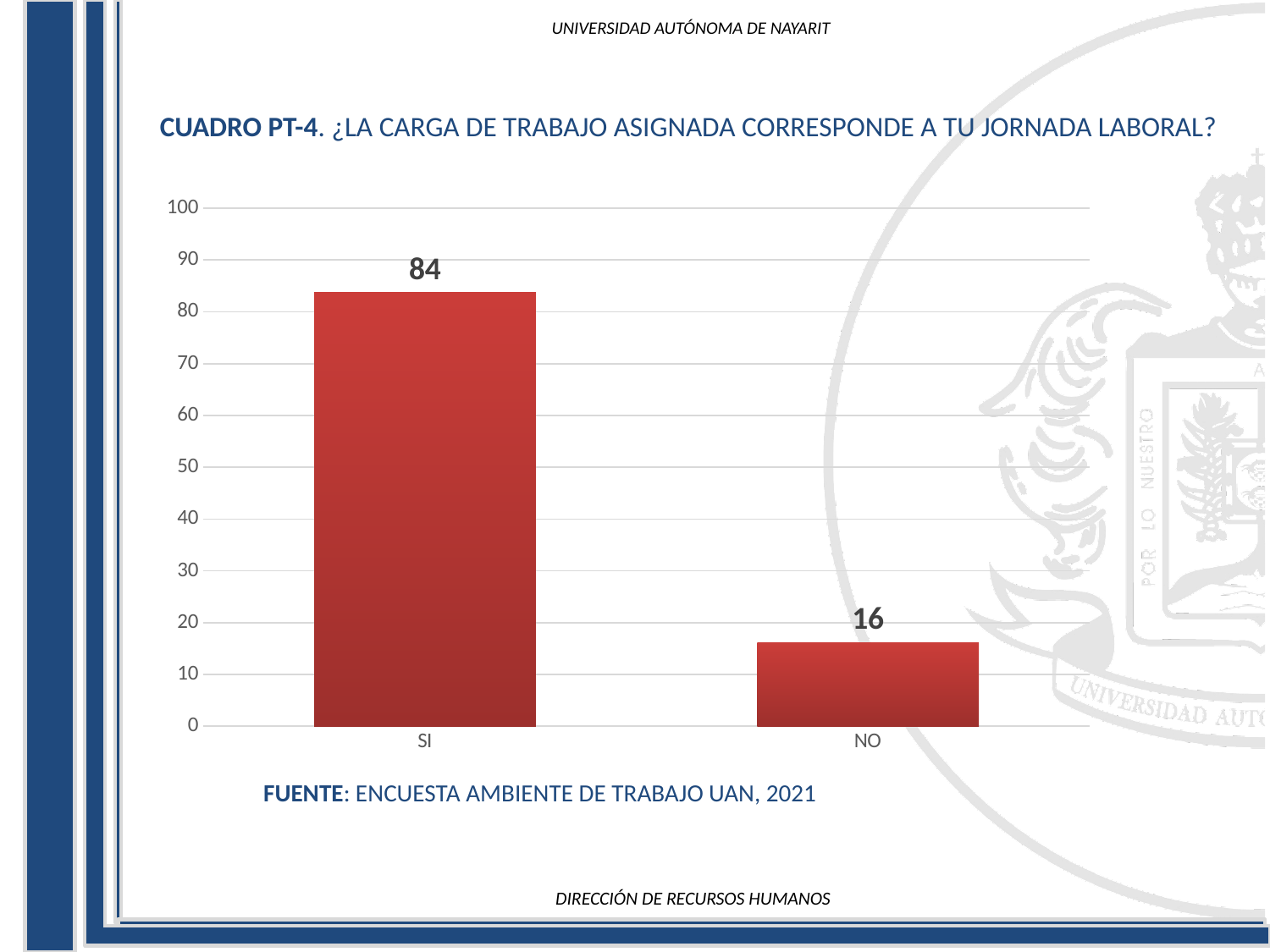
What is the value for SI? 84 What kind of chart is shown on the slide? bar chart Is the value for SI greater or less than 80? greater What is the difference between the values for SI and NO? 68 How many categories are shown on the x axis? 2 What is the value for NO? 16 What is the total of the two bars? 100 Which category has the lowest value? NO Is the value for NO greater or less than 20? less Which category has the highest value? SI Which is larger, the value for SI or the value for NO? SI What source is cited below the chart? ENCUESTA AMBIENTE DE TRABAJO UAN, 2021